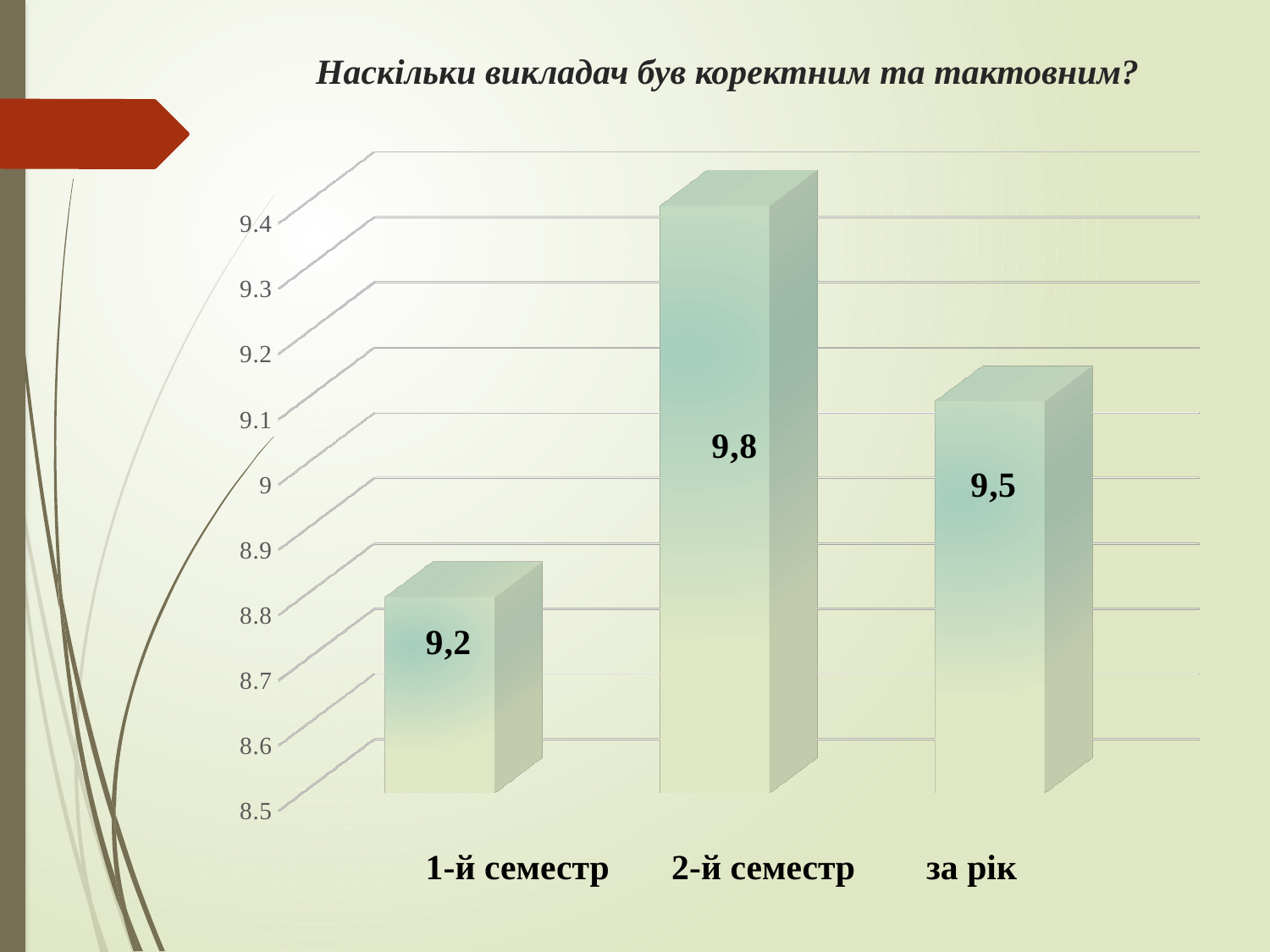
Which is larger, the value for 2-й семестр or the value for за рік? 2-й семестр Which category has the highest value? 2-й семестр What is the difference between the values for 2-й семестр and 1-й семестр? 0,6 What is the value for 1-й семестр? 9,2 What is the difference between the values for за рік and 1-й семестр? 0,3 Which category has the lowest value? 1-й семестр Does the value rise or fall from 1-й семестр to 2-й семестр? rise What kind of chart is shown on the slide? bar chart How many categories are shown on the chart? 3 What is the title of the chart? Наскільки викладач був коректним та тактовним? What is the value for за рік? 9,5 What is the value for 2-й семестр? 9,8